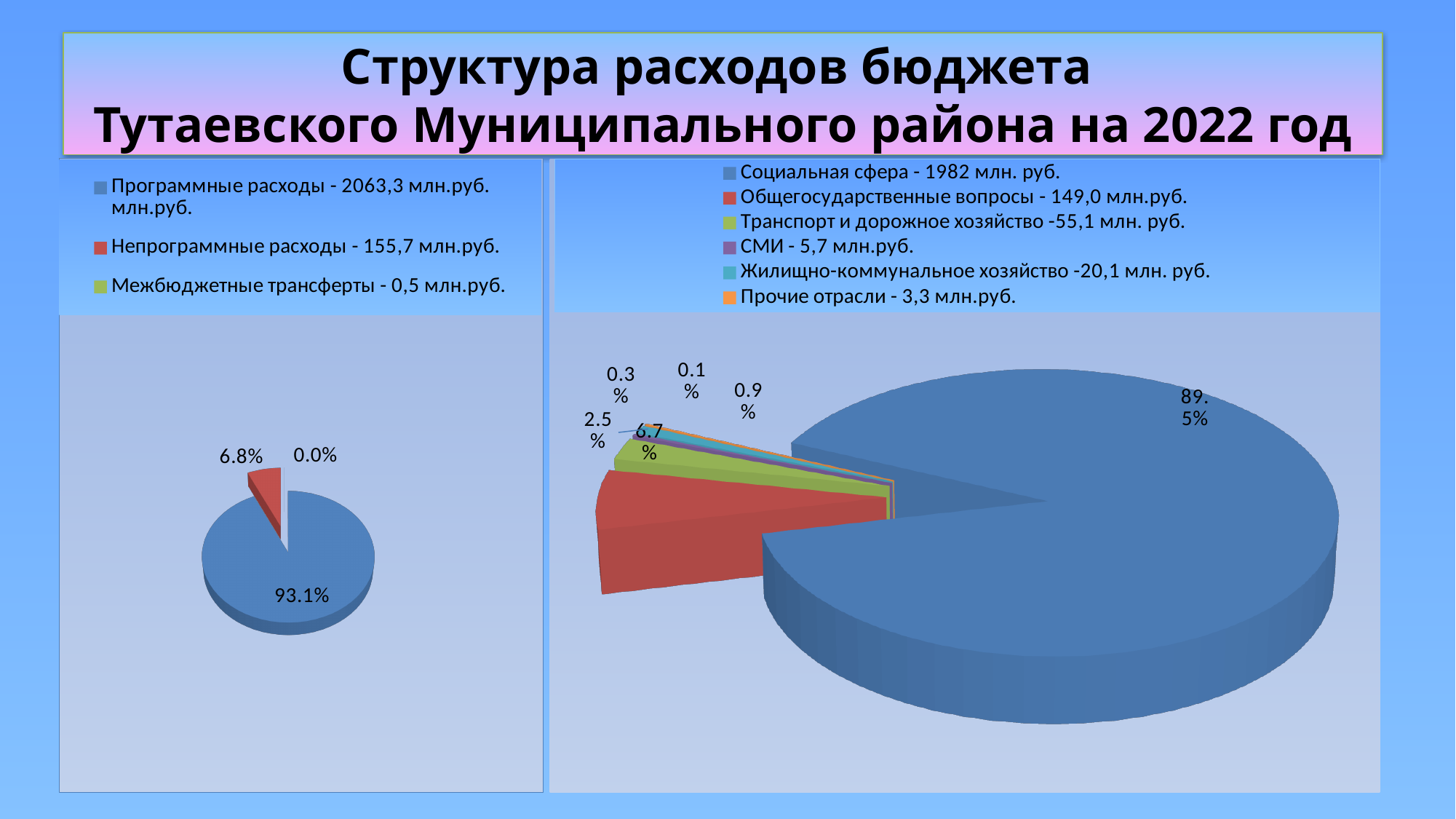
In the left pie chart, which category has the largest slice? Программные расходы In the right pie chart, which slice is larger: Общегосударственные вопросы or Транспорт и дорожное хозяйство? Общегосударственные вопросы What type of charts are shown on the slide? Pie charts In the left pie chart, what share is shown for Непрограммные расходы? 6.8% How many categories does the legend of the left pie chart list? 3 According to the legend of the right pie chart, what is the amount for Транспорт и дорожное хозяйство? 55,1 млн. руб. How many categories does the legend of the right pie chart list? 6 In the left pie chart, what share is shown for Программные расходы? 93.1% In the left pie chart, what share is shown for Межбюджетные трансферты? 0.0% In the right pie chart, which category has the largest slice? Социальная сфера